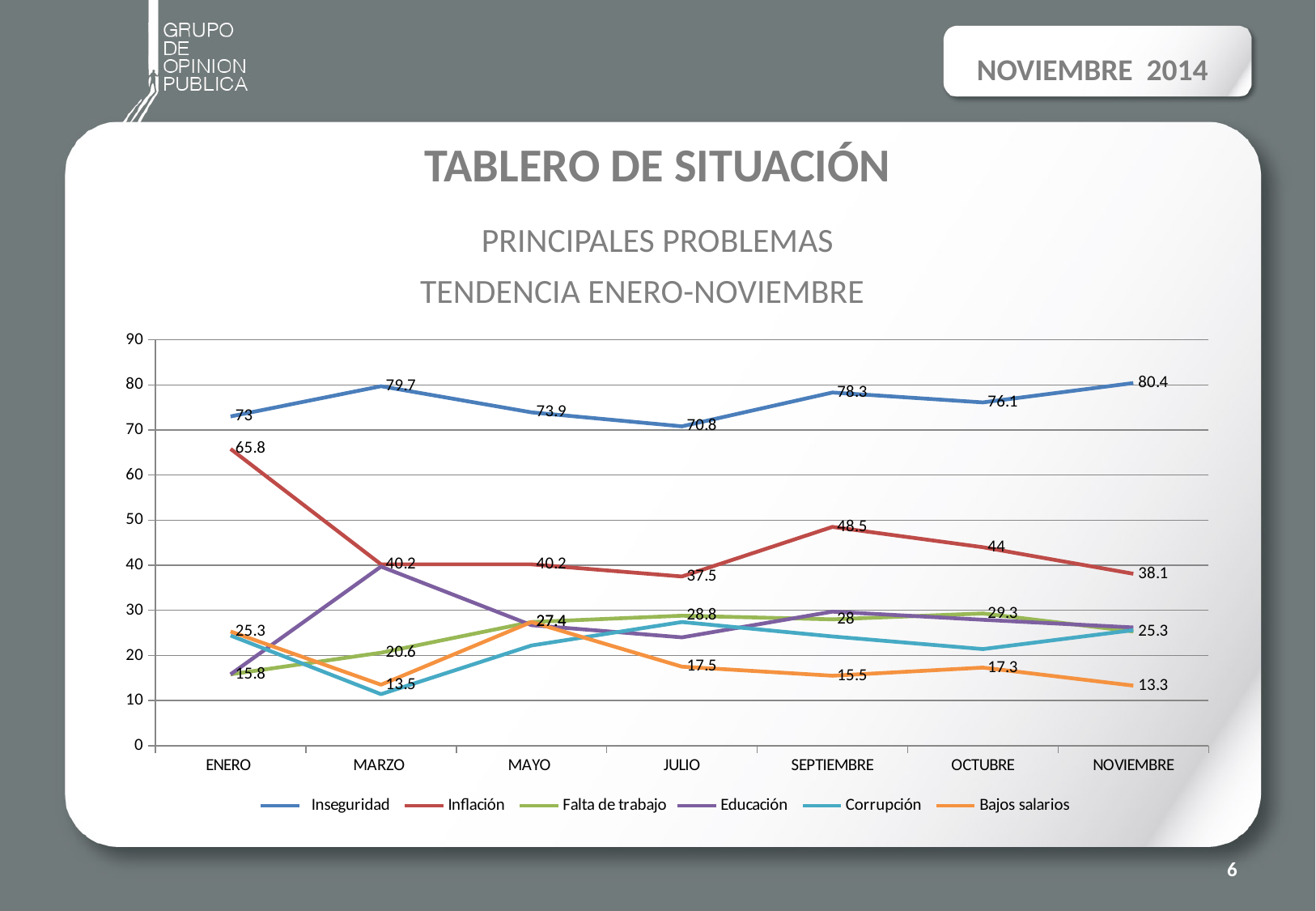
In which month does Inseguridad reach its highest value? NOVIEMBRE In which month does Inseguridad have its lowest value? JULIO How many months are shown along the x axis? 7 What is the value for Inflación in ENERO? 65.8 What kind of chart is shown on the slide? line chart What is the difference between Inseguridad and Inflación in NOVIEMBRE? 42.3 Which is larger in MARZO, Inseguridad or Inflación? Inseguridad What is the value for Inflación in SEPTIEMBRE? 48.5 Does the Inflación line rise or fall from ENERO to MARZO? fall What is the value for Inseguridad in NOVIEMBRE? 80.4 How many series does the legend list? 6 Is the value for Bajos salarios in NOVIEMBRE greater or less than 20? less